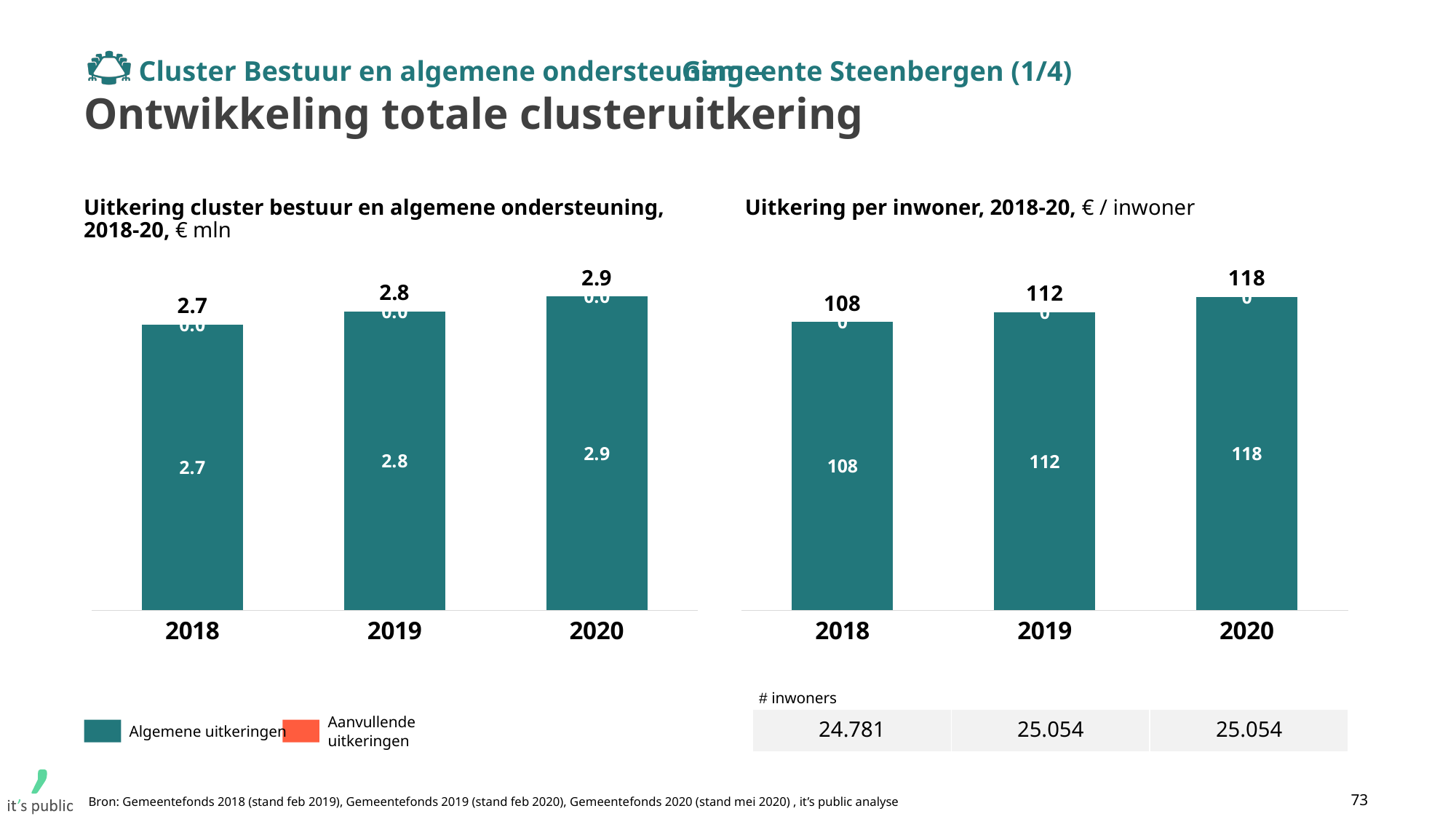
In the right chart (Uitkering per inwoner), which year has the highest value? 2020 In the right chart (Uitkering per inwoner), what is the value for 2019? 112 In the right chart (Uitkering per inwoner), do the values rise or fall from 2018 to 2020? Rise In the left chart (Uitkering cluster bestuur en algemene ondersteuning), which year has the lowest total? 2018 In the right chart (Uitkering per inwoner), what is the difference between the 2020 and 2018 values? 10 How many years are shown on the x axis of the right chart (Uitkering per inwoner)? 3 In the left chart (Uitkering cluster bestuur en algemene ondersteuning), which is larger: the total for 2019 or for 2020? 2020 What kind of chart is the right chart (Uitkering per inwoner)? Bar chart In the left chart, what is the value of the Aanvullende uitkeringen segment for 2019? 0.0 In the left chart (Uitkering cluster bestuur en algemene ondersteuning), what is the total value for 2020? 2.9 In the left chart (Uitkering cluster bestuur en algemene ondersteuning), what is the total value for 2018? 2.7 How many series does the legend of the left chart list? 2